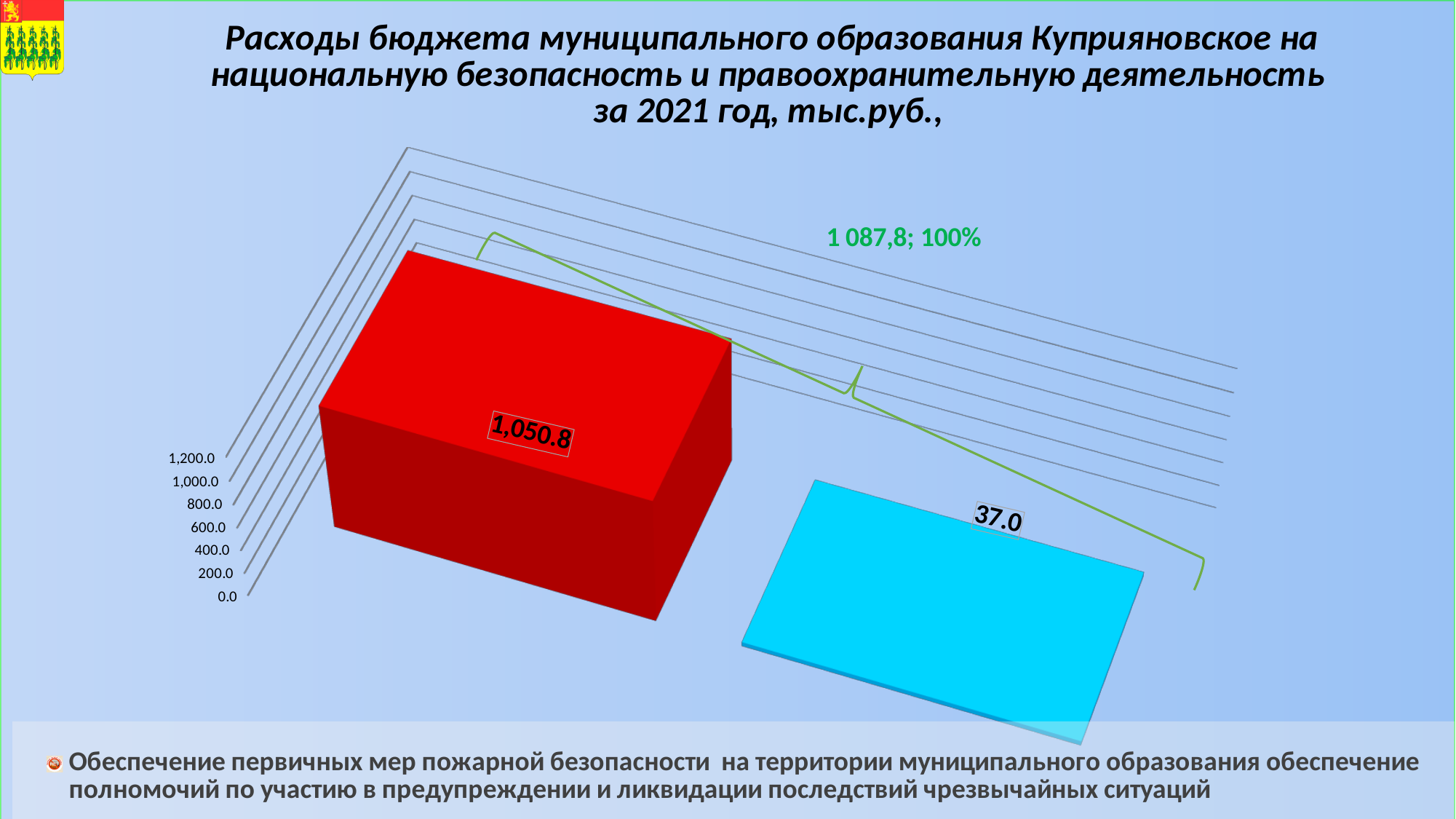
What total value is printed in green on the chart? 1 087,8 What is the highest tick value shown on the vertical axis? 1,200.0 What value is shown on the light blue bar? 37.0 What is the difference between the red bar value and the light blue bar value? 1,013.8 Which bar is the highest, the red one or the light blue one? the red bar What value is shown on the red bar? 1,050.8 Which bar is the lowest, the red one or the light blue one? the light blue bar How many bars are plotted on the chart? 2 Is the value of the red bar larger or smaller than the value of the light blue bar? larger Is the value for the light blue bar greater or less than 200.0? less What kind of chart is shown on the slide? bar chart Is the value for the red bar greater or less than 1,000.0? greater